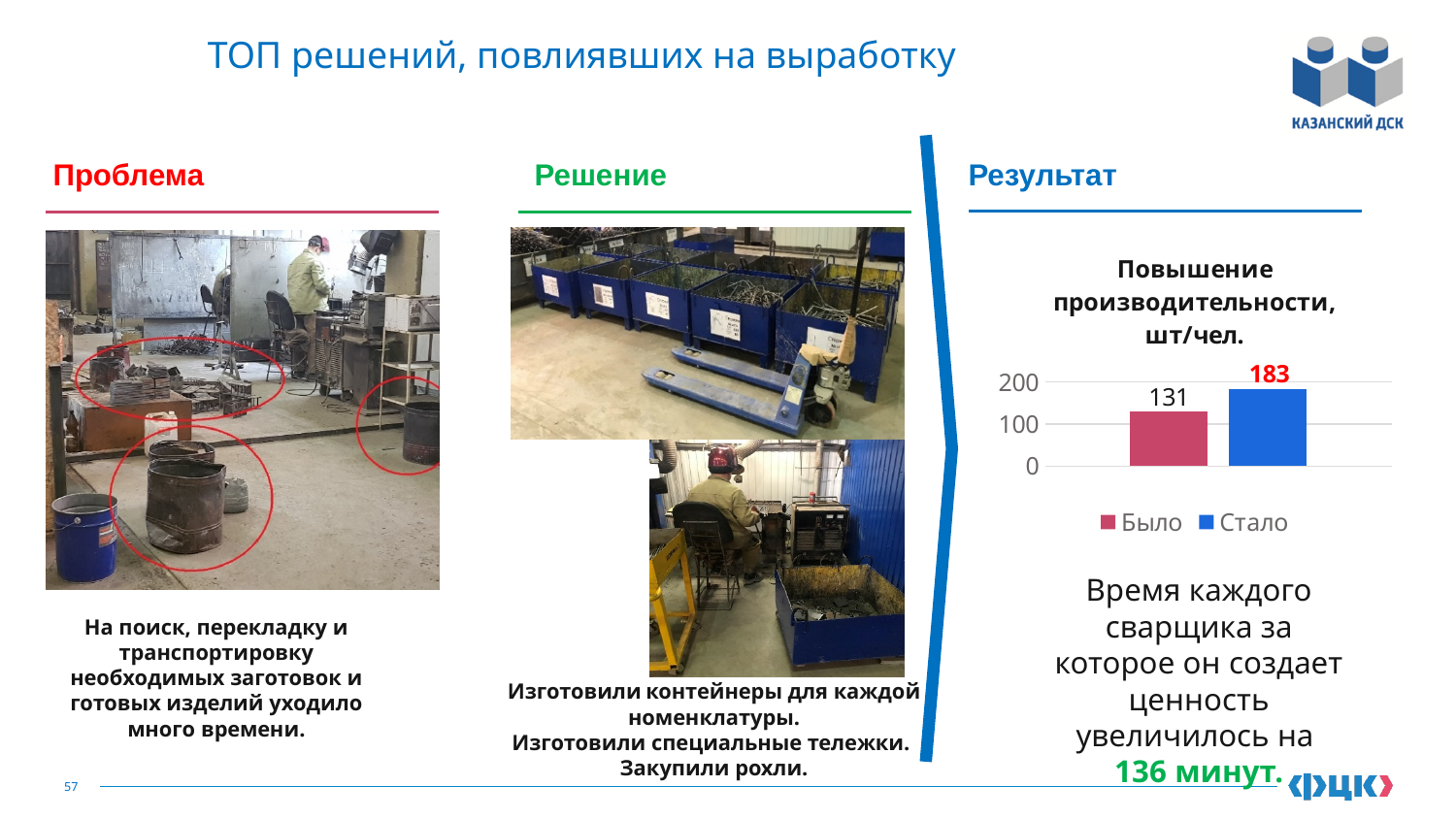
What colour is the "Стало" bar in the chart? blue What is the value for "Стало" in the chart? 183 Which series has the lowest value in the chart? Было Which series has the higher value, "Было" or "Стало"? Стало What is the difference between the "Стало" and "Было" values? 52 Which series has the highest value in the chart? Стало How many series does the chart legend list? 2 What kind of chart is shown on the slide? bar chart Is the value for "Было" greater or less than 200? less What is the value for "Было" in the chart? 131 Is the value for "Стало" greater or less than 100? greater What is the title of the chart? Повышение производительности, шт/чел.